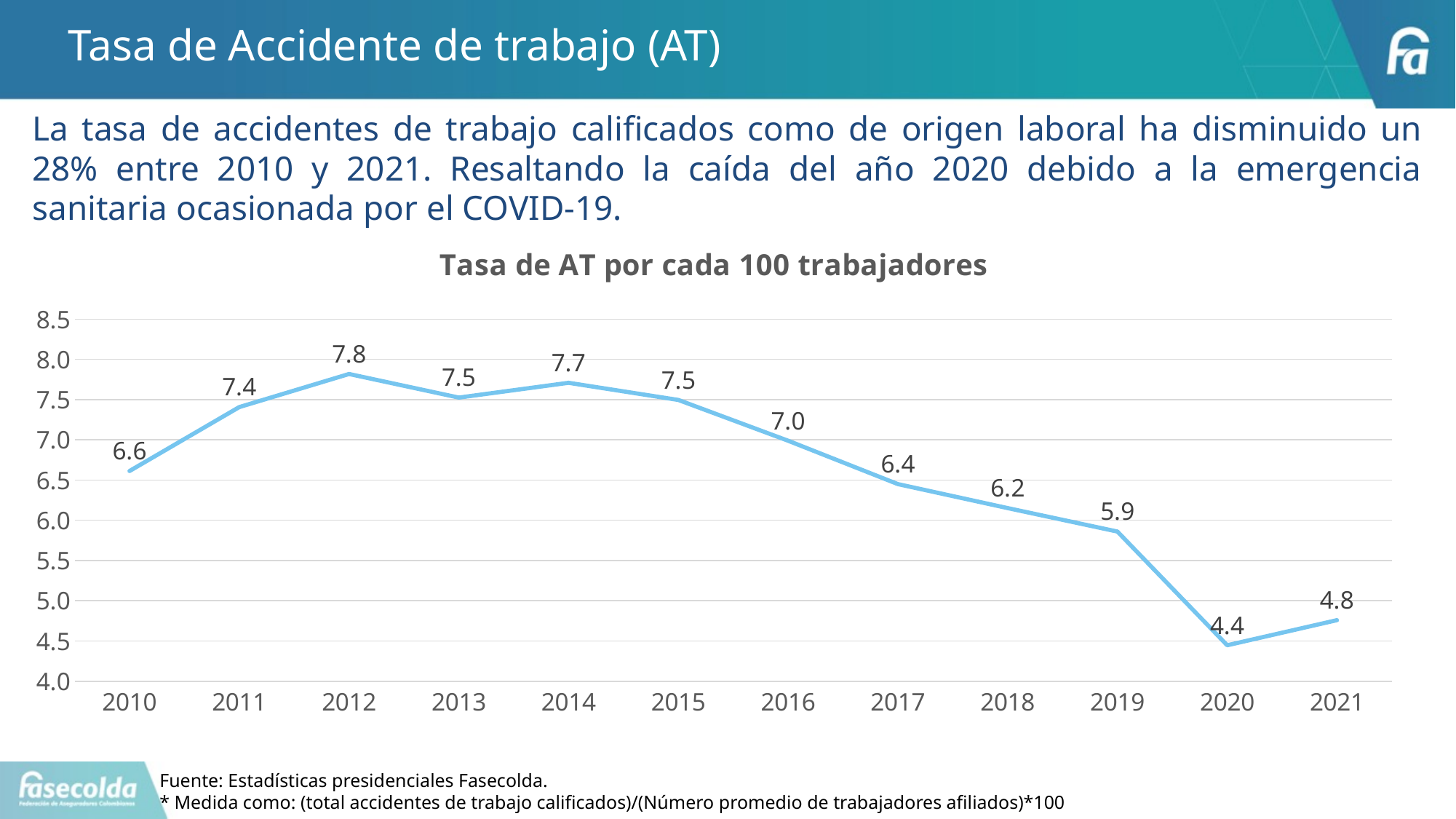
Which year has the highest value? 2012 What is the value for 2012? 7.8 What is the difference between the values for 2019 and 2020? 1.5 Is the value for 2018 greater or less than 6.0? greater What kind of chart is shown? line chart What is the value for 2020? 4.4 What is the difference between the values for 2010 and 2021? 1.8 Which is larger, the value for 2011 or the value for 2017? 2011 How many years are plotted on the chart? 12 Which year has the lowest value? 2020 What is the title of the chart? Tasa de AT por cada 100 trabajadores What is the value for 2016? 7.0